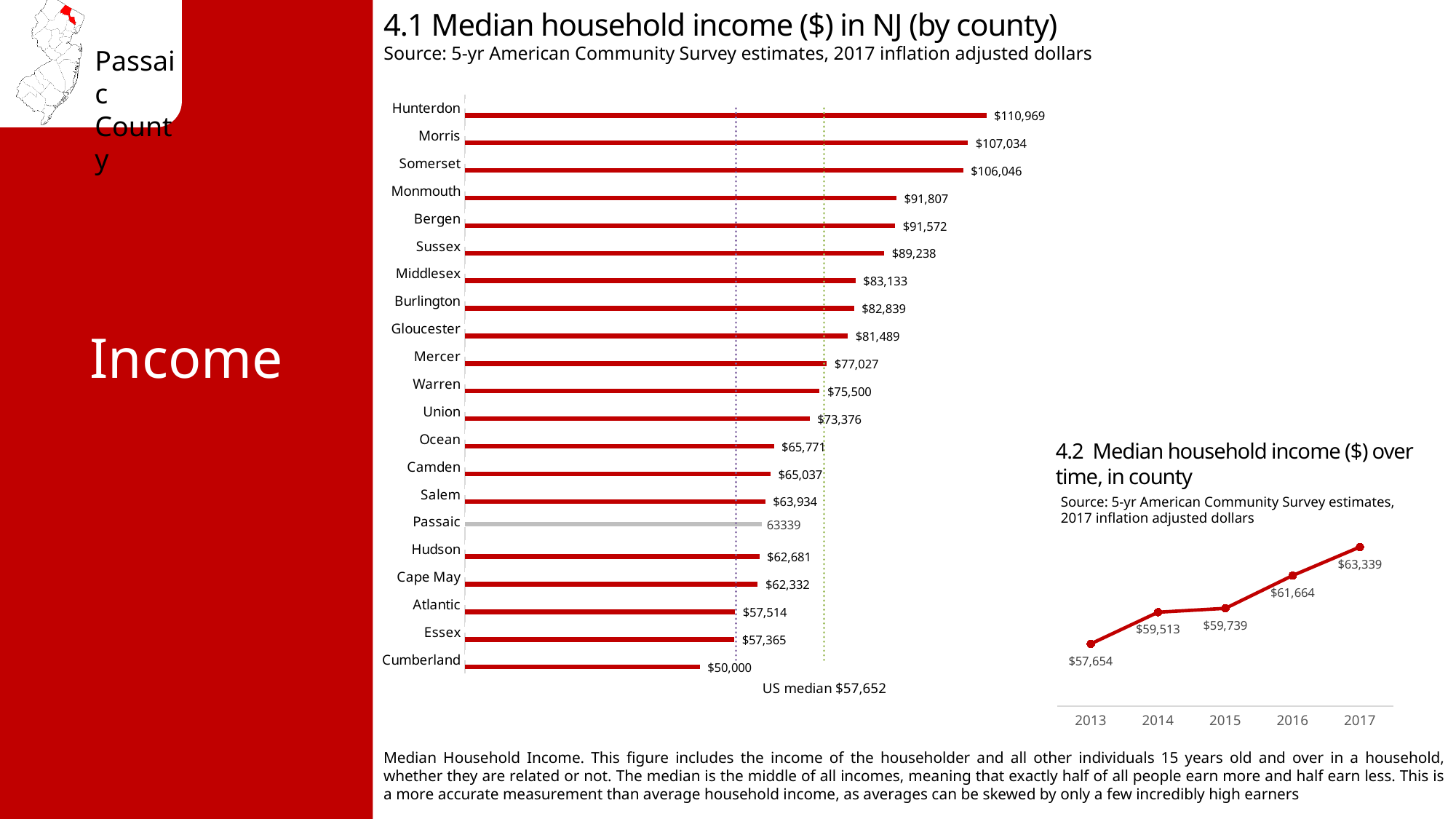
In chart 4.2 Median household income over time, in county, do the values rise or fall from 2013 to 2017? Rise In chart 4.1 Median household income in NJ (by county), what US median value is noted below the chart? $57,652 In chart 4.1 Median household income in NJ (by county), what is the value shown for Passaic? 63339 What kind of chart is chart 4.1 Median household income in NJ (by county)? Bar chart In chart 4.2 Median household income over time, in county, what is the value for 2013? $57,654 In chart 4.1 Median household income in NJ (by county), which county has the highest median household income? Hunterdon In chart 4.1 Median household income in NJ (by county), which county has a higher median household income, Ocean or Camden? Ocean In chart 4.1 Median household income in NJ (by county), what is the difference between the values for Morris and Somerset? $988 In chart 4.1 Median household income in NJ (by county), what is the median household income for Hunterdon? $110,969 In chart 4.1 Median household income in NJ (by county), which county has the lowest median household income? Cumberland In chart 4.1 Median household income in NJ (by county), how many counties are plotted? 21 In chart 4.2 Median household income over time, in county, what is the difference between the 2017 and 2016 values? $1,675